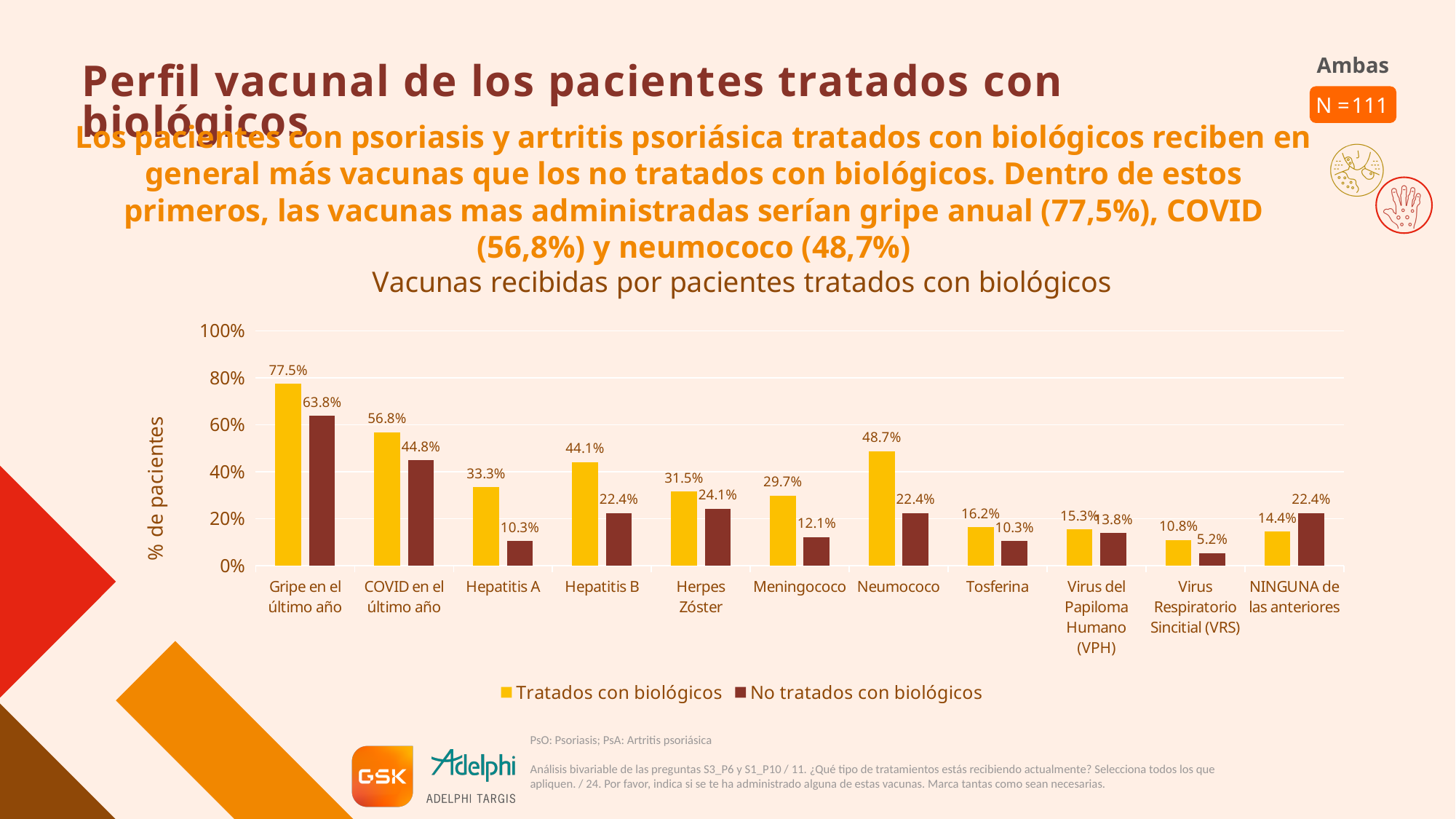
Which vaccine category has the highest value for Tratados con biológicos? Gripe en el último año What is the difference between Tratados con biológicos and No tratados con biológicos for Hepatitis A? 23.0% What type of chart is shown on the slide? Bar chart How many series does the legend list? 2 How many vaccine categories are shown on the x axis? 11 Which category has the lowest value for No tratados con biológicos? Virus Respiratorio Sincitial (VRS) What is the title of the chart? Vacunas recibidas por pacientes tratados con biológicos What is the value for No tratados con biológicos for Neumococo? 22.4% What is the value for Tratados con biológicos for Virus Respiratorio Sincitial (VRS)? 10.8% What percentage of patients treated with biologics (Tratados con biológicos) received the Gripe en el último año vaccine? 77.5% Is the value for Tratados con biológicos for COVID en el último año greater or less than 40%? greater For NINGUNA de las anteriores, which series has the larger value: Tratados con biológicos or No tratados con biológicos? No tratados con biológicos